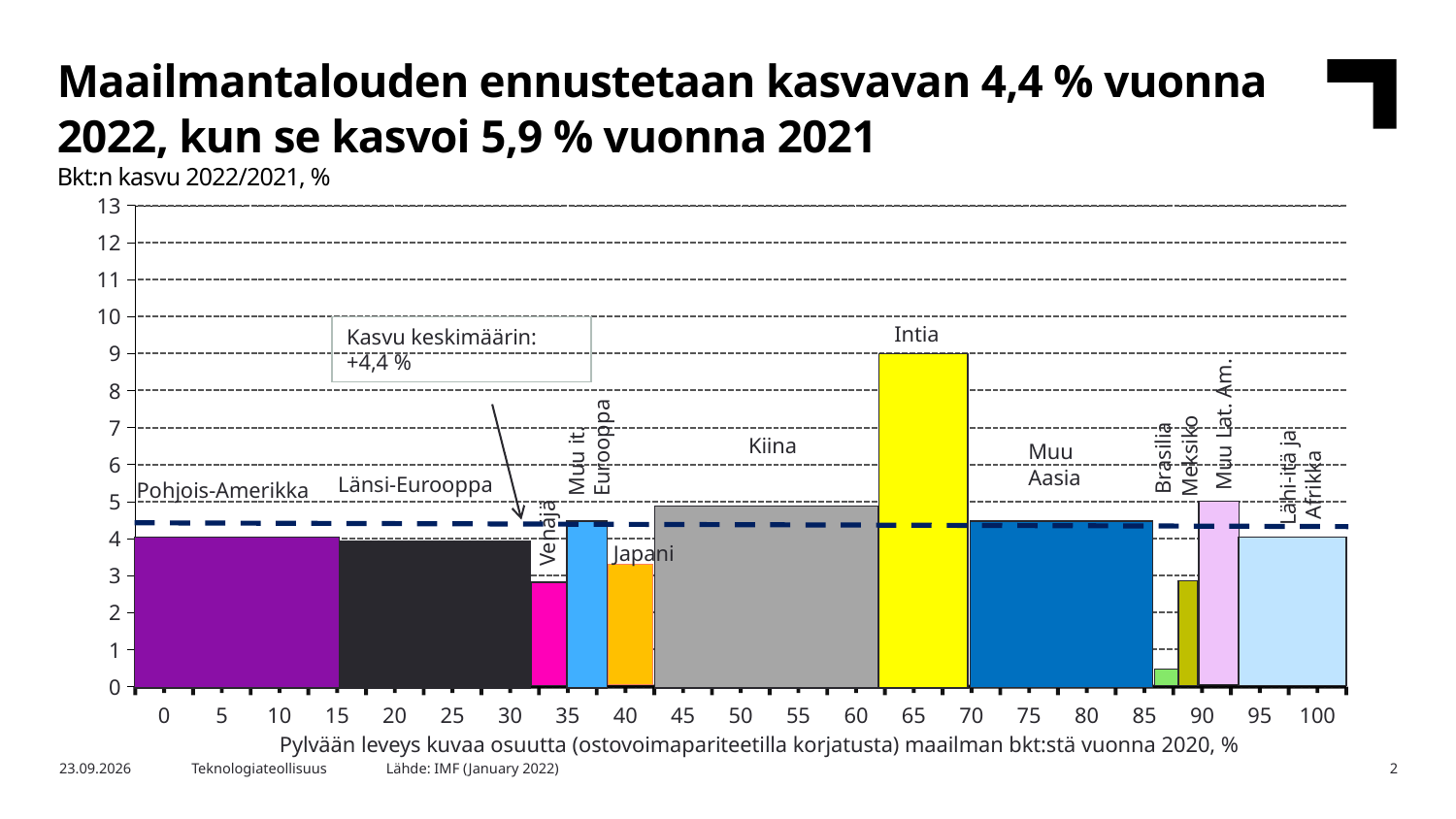
Is the value for Venäjä greater or less than 3? less Which region has the highest GDP growth in the chart? Intia What kind of chart is shown on the slide? bar chart How many regions are shown as bars in the chart? 12 Is the value for Kiina greater or less than 4? greater Which has the higher GDP growth, Intia or Kiina? Intia Is the value for Brasilia greater or less than 1? less Which region has the lowest GDP growth in the chart? Brasilia Which has the higher GDP growth, Meksiko or Brasilia? Meksiko What average growth value is indicated by the dashed line annotation? +4,4 % What does the width of each bar represent according to the note below the chart? Share of world GDP in 2020 (PPP-adjusted), %